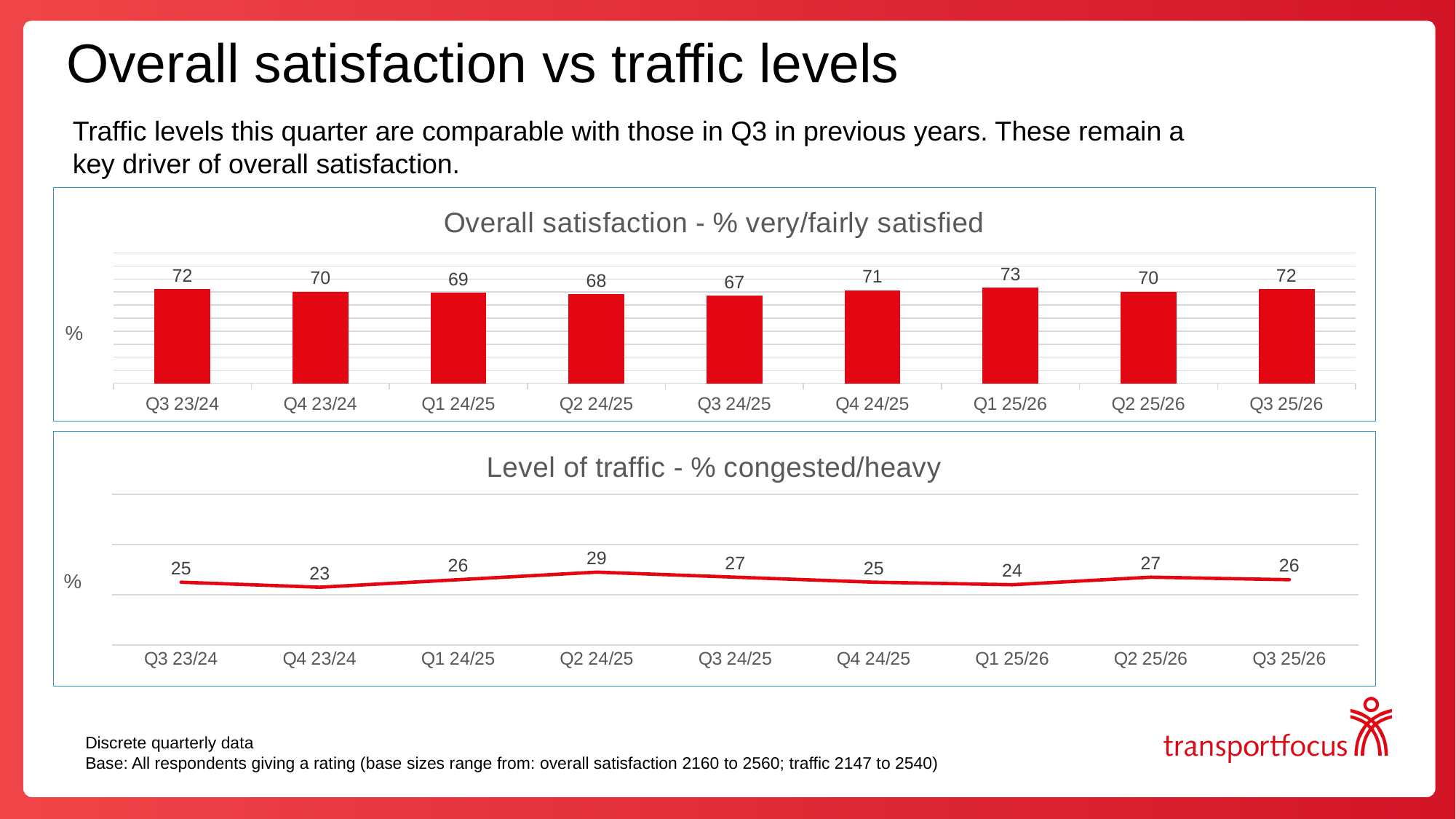
In the 'Overall satisfaction - % very/fairly satisfied' chart, how many quarters are shown? 9 In the 'Overall satisfaction - % very/fairly satisfied' chart, which quarter has the lowest value? Q3 24/25 In the 'Level of traffic - % congested/heavy' chart, which quarter has the highest value? Q2 24/25 In the 'Level of traffic - % congested/heavy' chart, which quarter has the lowest value? Q4 23/24 In the 'Level of traffic - % congested/heavy' chart, which is larger: Q3 24/25 or Q1 25/26? Q3 24/25 What kind of chart is the 'Overall satisfaction - % very/fairly satisfied' chart? Bar chart In the 'Overall satisfaction - % very/fairly satisfied' chart, what is the difference between Q1 25/26 and Q3 24/25? 6 In the 'Level of traffic - % congested/heavy' chart, what is the value for Q2 24/25? 29 In the 'Overall satisfaction - % very/fairly satisfied' chart, what is the value for Q3 25/26? 72 In the 'Overall satisfaction - % very/fairly satisfied' chart, which quarter has the highest value? Q1 25/26 In the 'Level of traffic - % congested/heavy' chart, what is the difference between Q2 24/25 and Q4 23/24? 6 What kind of chart is the 'Level of traffic - % congested/heavy' chart? Line chart